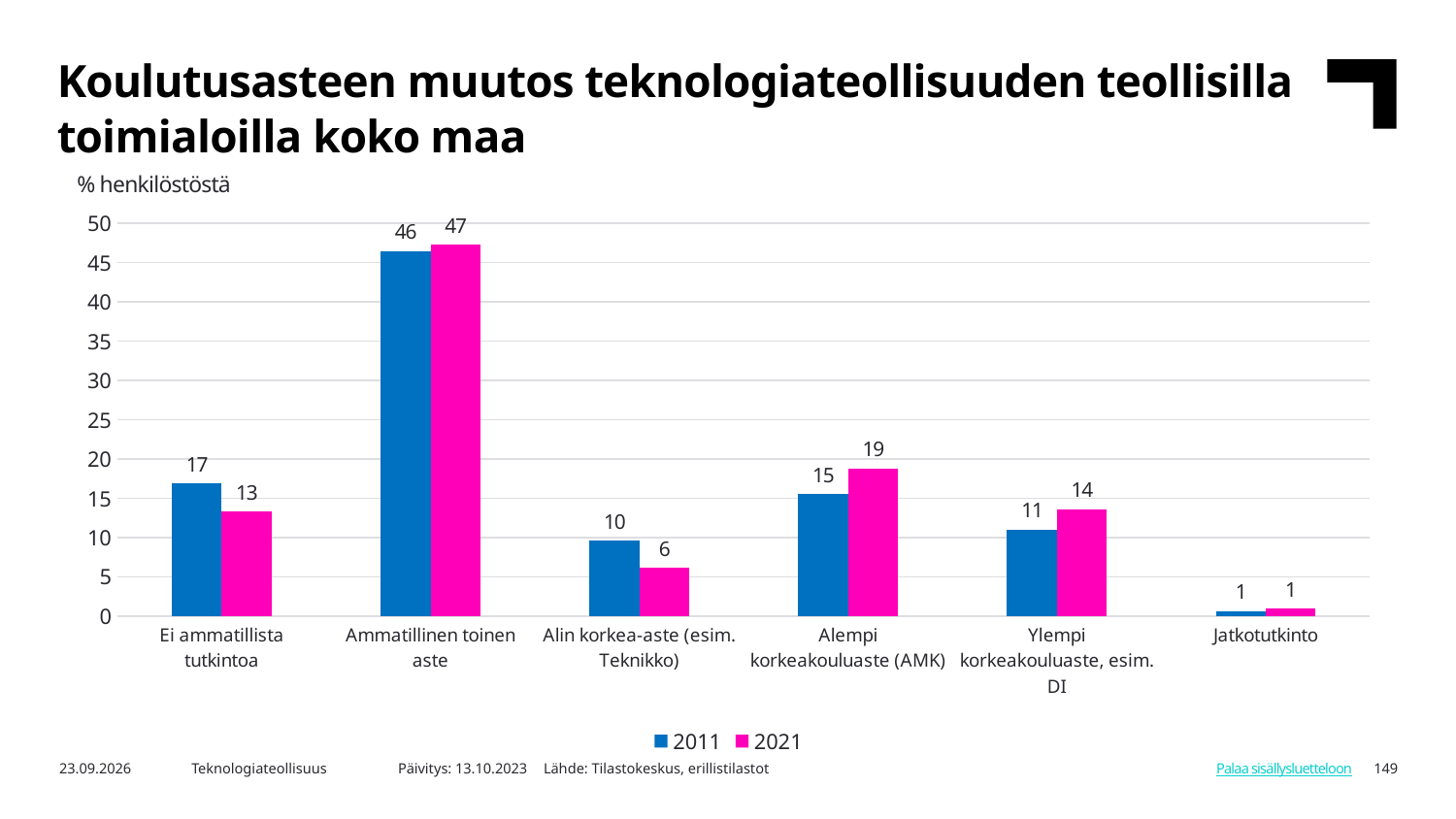
What is the 2011 value for Ei ammatillista tutkintoa? 17 How many series does the legend list? 2 How many education categories are shown on the x axis? 6 What is the 2021 value for Alin korkea-aste (esim. Teknikko)? 6 What is the 2021 value for Ammatillinen toinen aste? 47 What is the 2011 value for Ylempi korkeakouluaste, esim. DI? 11 What kind of chart is shown on the slide? Bar chart Which category has the lowest 2011 value? Jatkotutkinto For Ei ammatillista tutkintoa, which year has the larger value, 2011 or 2021? 2011 What is the difference between the 2021 and 2011 values for Alempi korkeakouluaste (AMK)? 4 Which colour represents the 2021 series? Magenta (pink) Which category has the highest 2021 value? Ammatillinen toinen aste